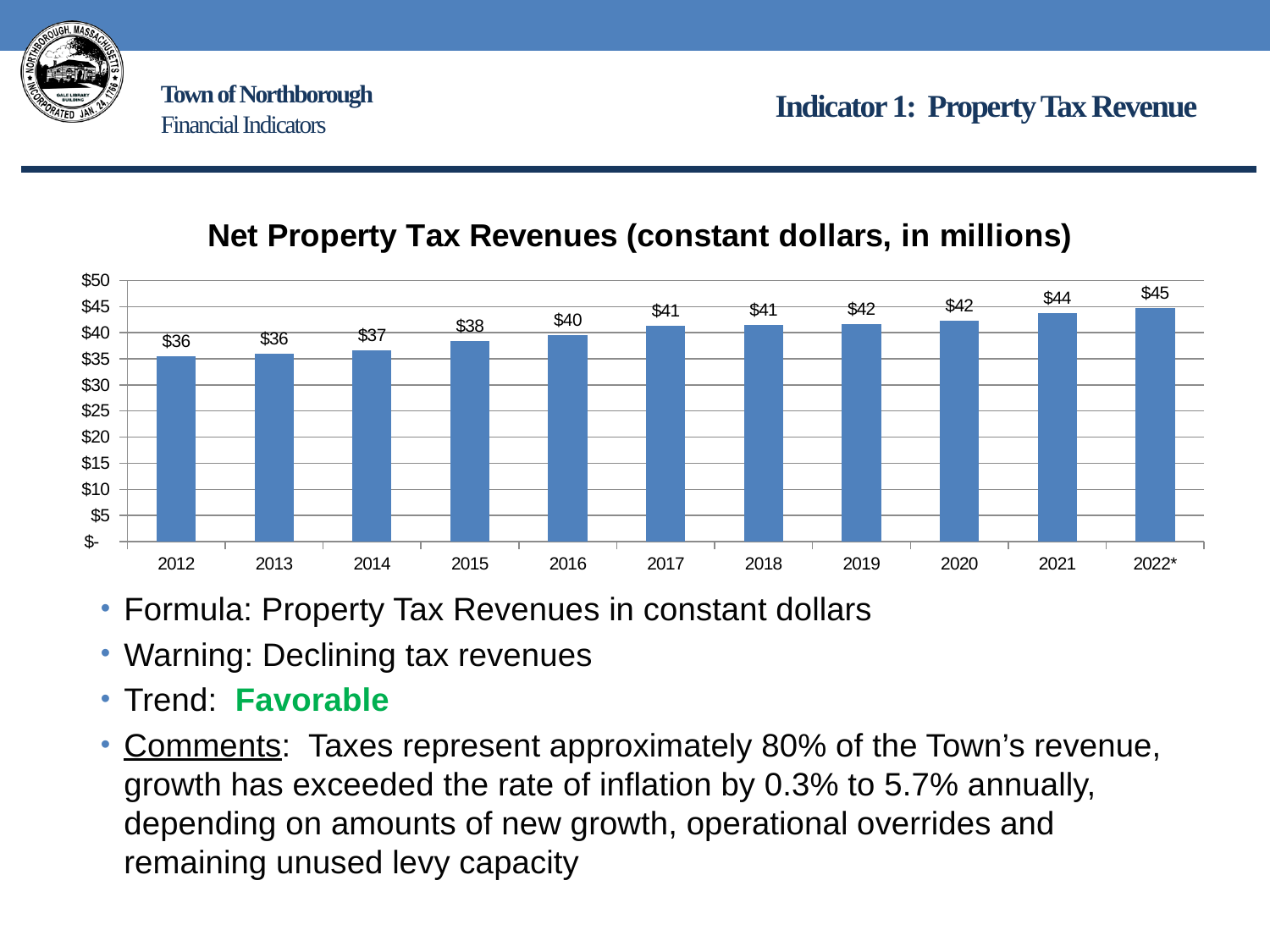
Is the value for 2014 greater or less than $40? less What kind of chart is used to show net property tax revenues? bar chart Which year has the highest net property tax revenue? 2022* Do the net property tax revenue values rise or fall from 2012 to 2022*? rise How many years are shown on the x axis of the chart? 11 What is the difference between the 2022* value and the 2012 value? $9 Which is larger, the value for 2015 or the value for 2019? 2019 What is the net property tax revenue value shown for 2012? $36 What is the title of the chart? Net Property Tax Revenues (constant dollars, in millions) What is the net property tax revenue value shown for 2016? $40 What is the net property tax revenue value shown for 2022*? $45 What is the net property tax revenue value shown for 2021? $44